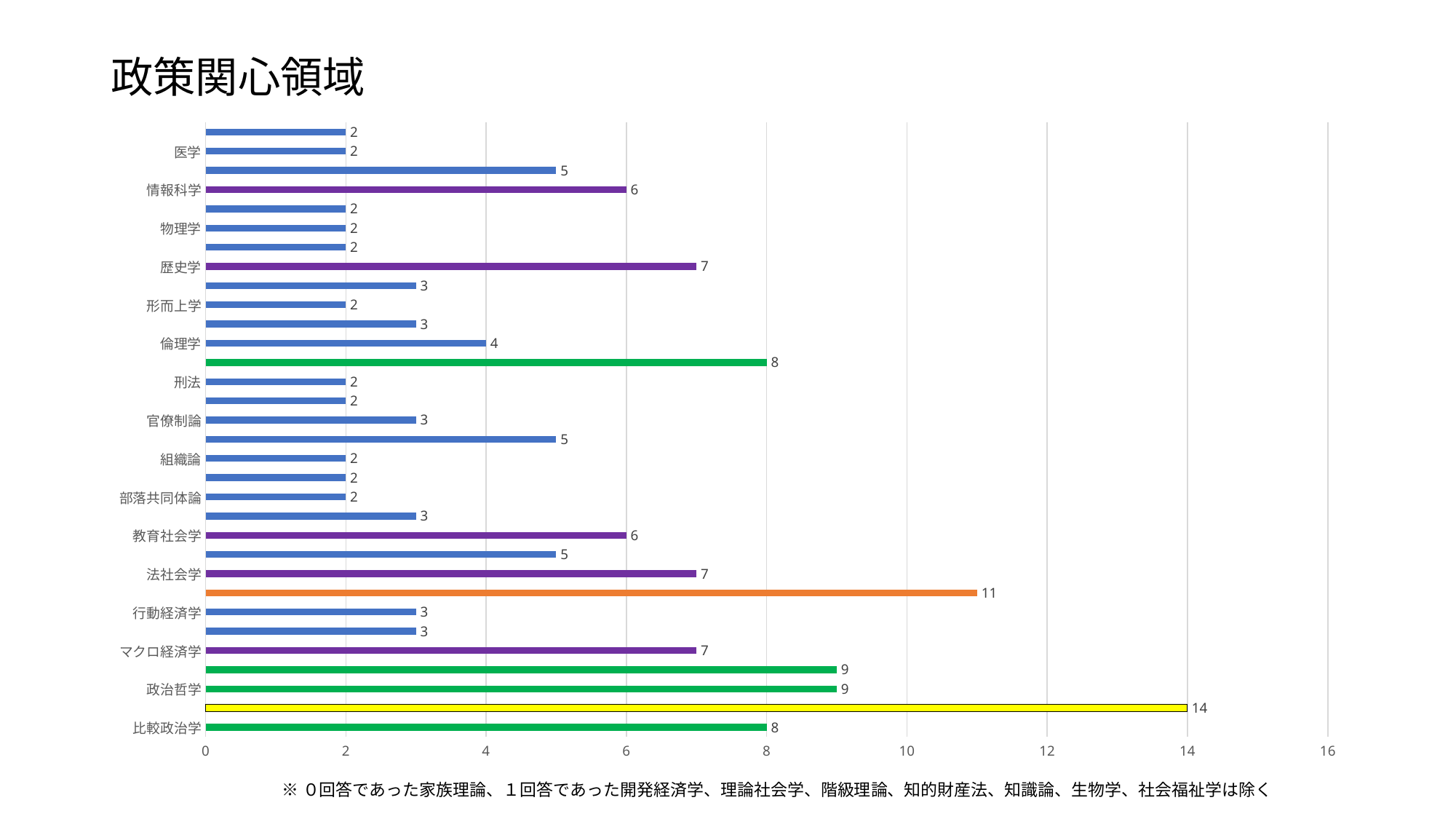
What is the value for マクロ経済学? 7 What is the value for 比較政治学? 8 How many bars are plotted on the chart? 32 What is the title of the slide? 政策関心領域 What is the largest value shown on the chart? 14 What is the value for 政治哲学? 9 What is the value for 情報科学? 6 What is the difference between the values for 法社会学 and 行動経済学? 4 What kind of chart is shown on the slide? bar chart What is the value for 歴史学? 7 Which has a larger value, 教育社会学 or 官僚制論? 教育社会学 What is the value for 倫理学? 4